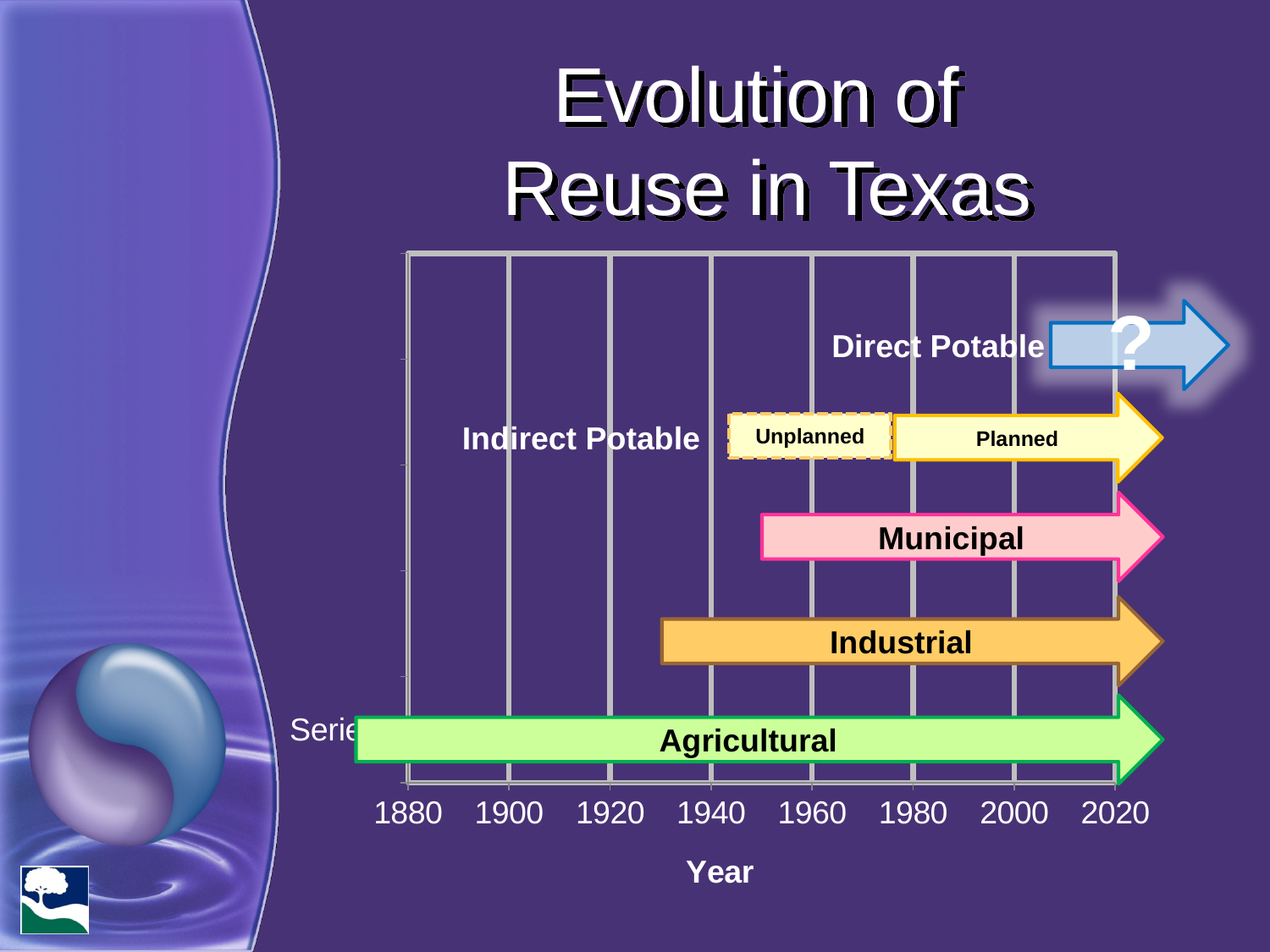
Does the Municipal arrow begin before or after 1940? after How many reuse categories are shown as arrows on the chart? 5 What is the title of the chart on the slide? Evolution of Reuse in Texas Does the Industrial arrow begin before or after 1940? before What is the earliest year shown on the x axis? 1880 Which reuse category's arrow begins earliest on the timeline? Agricultural What is the label of the x axis? Year What is the latest year shown on the x axis? 2020 Does the Direct Potable arrow begin before or after 2000? after How many year tick labels are shown on the x axis? 8 Into which two segments is the Indirect Potable arrow divided? Unplanned and Planned Which reuse category's arrow begins latest on the timeline? Direct Potable